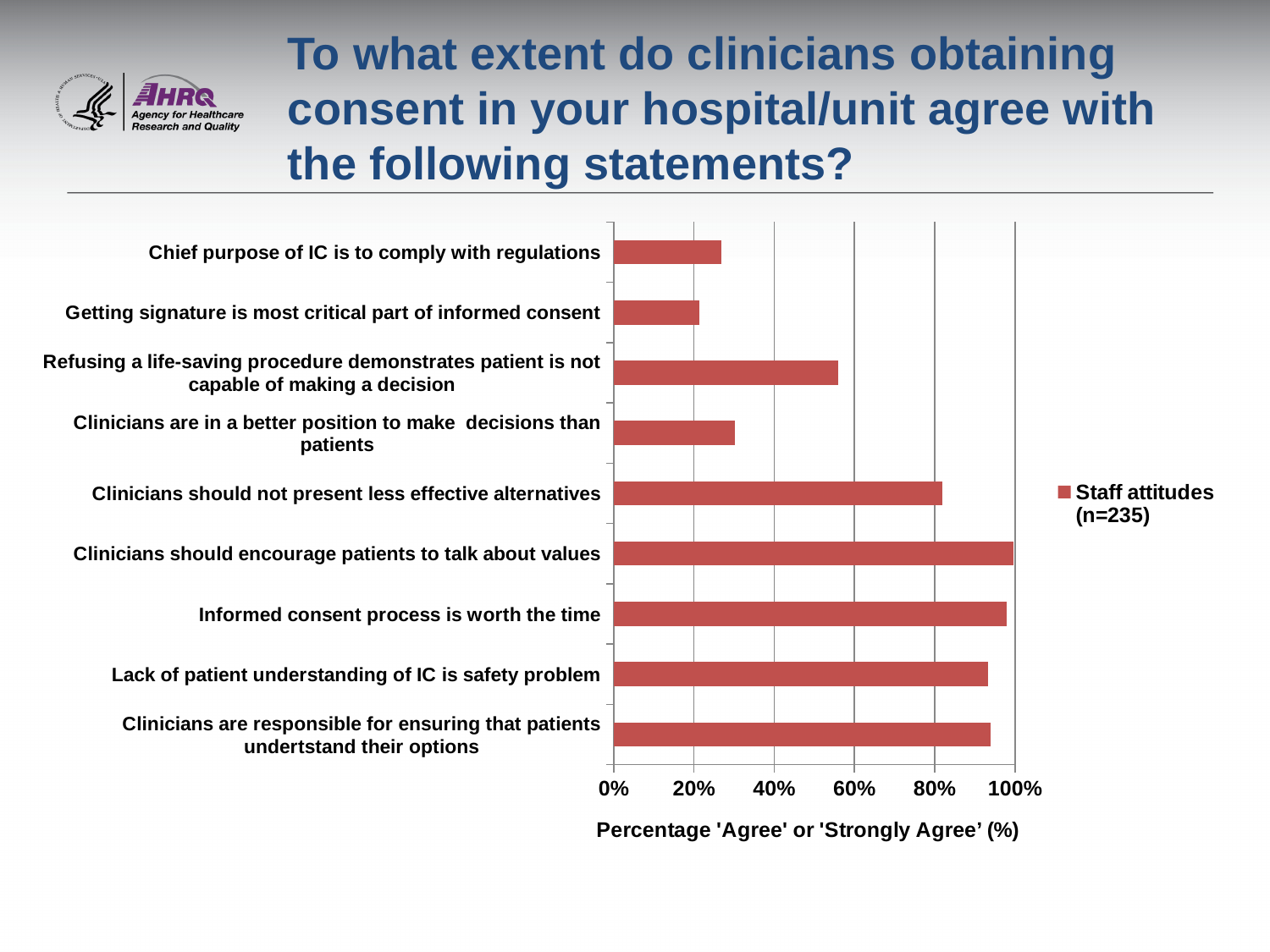
Is the value for 'Lack of patient understanding of IC is safety problem' greater or less than 80%? greater Which has a higher value: 'Clinicians should not present less effective alternatives' or 'Informed consent process is worth the time'? Informed consent process is worth the time What kind of chart is shown on the slide? bar chart What is the legend entry for the series in the chart? Staff attitudes (n=235) How many statements (categories) are plotted in the chart? 9 Which has a higher value: 'Refusing a life-saving procedure demonstrates patient is not capable of making a decision' or 'Clinicians are in a better position to make decisions than patients'? Refusing a life-saving procedure demonstrates patient is not capable of making a decision Is the value for 'Clinicians should not present less effective alternatives' greater or less than 60%? greater Is the value for 'Chief purpose of IC is to comply with regulations' greater or less than 40%? less Which statement has the lowest percentage of agreement? Getting signature is most critical part of informed consent How many series does the legend list? 1 What is the title of the horizontal axis? Percentage 'Agree' or 'Strongly Agree' (%)